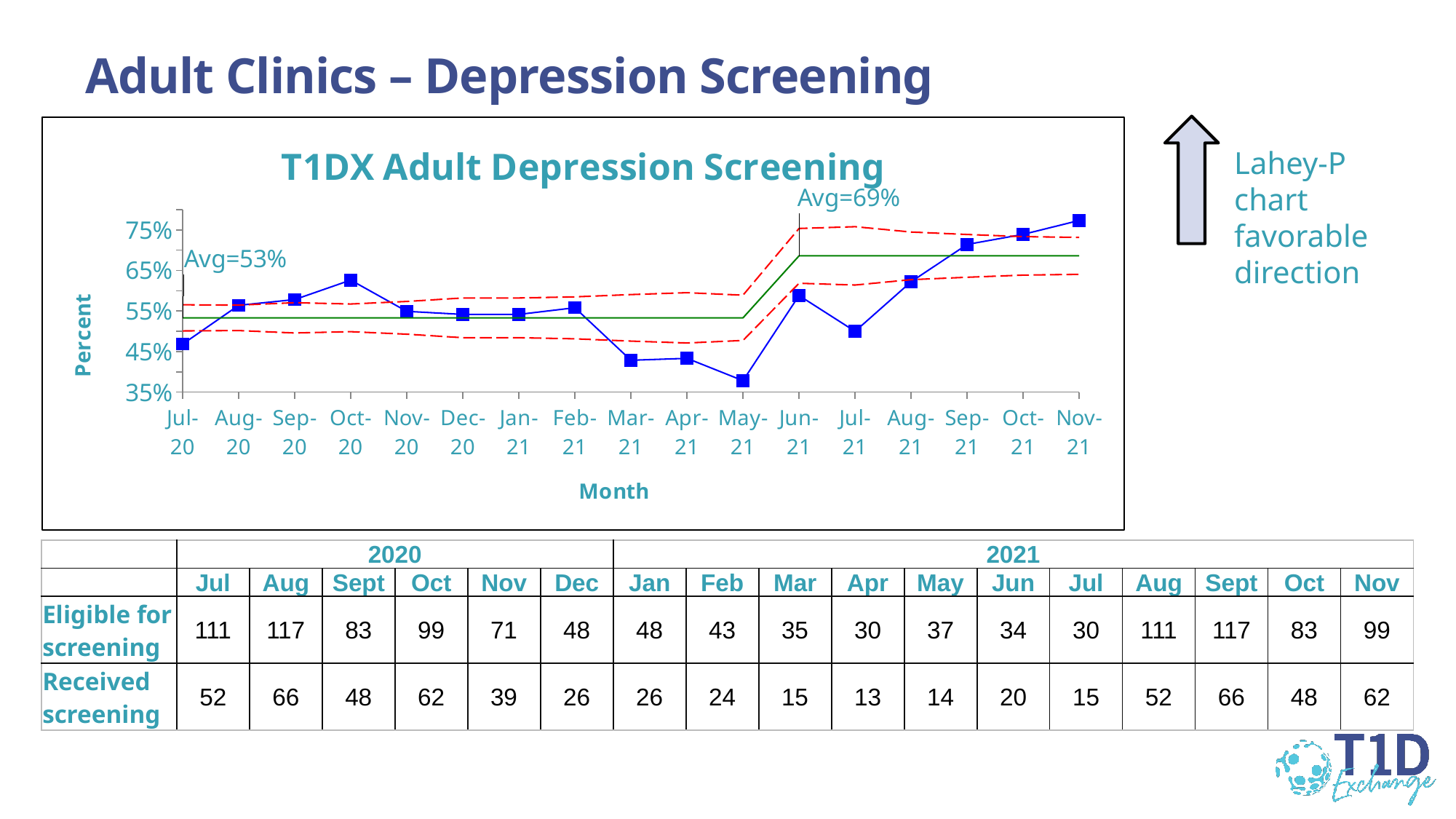
Is the value for Oct-20 greater or less than 55%? greater What kind of chart is the T1DX Adult Depression Screening chart? line chart What average value is annotated for the first period of the chart (starting Jul-20)? Avg=53% Which month has the highest plotted value on the chart? Nov-21 Do the plotted values rise or fall from Feb-21 to May-21? fall How many monthly data points are plotted on the T1DX Adult Depression Screening chart? 17 Which is larger, the value for Jun-21 or the value for Jul-21? Jun-21 What is the title of the chart on the slide? T1DX Adult Depression Screening What is the label on the vertical axis of the chart? Percent Is the value for May-21 greater or less than 45%? less Which month has the lowest plotted value on the chart? May-21 What average value is annotated for the later period of the chart (starting Jun-21)? Avg=69%